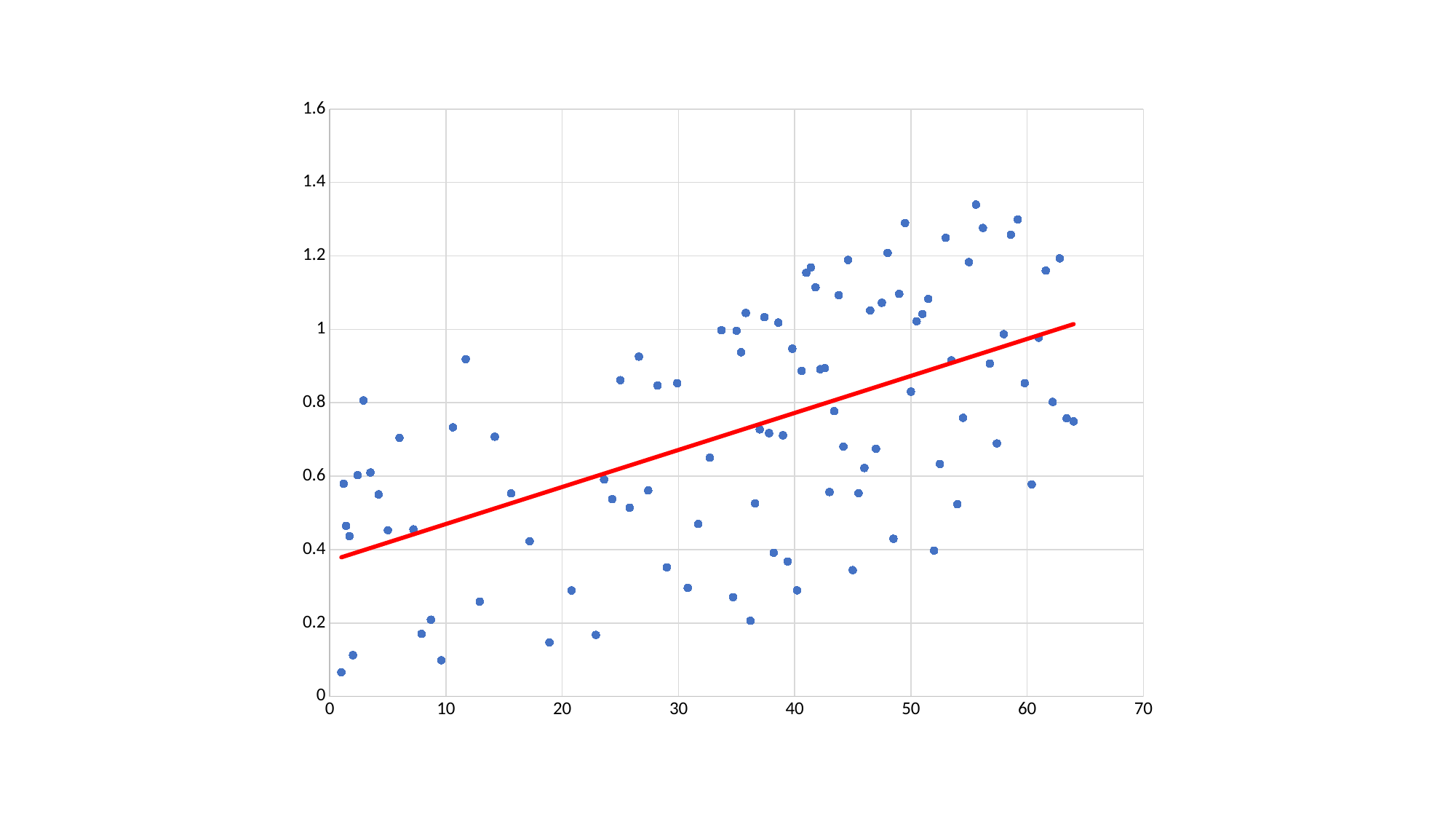
Are any plotted points above 1.4 on the y axis? no What kind of chart is shown on the slide? scatter chart Is the value of the red trend line at x = 50 greater or less than 0.8? greater Is the value of the red trend line at x = 30 greater or less than 0.8? less Does the red trend line slope upward or downward from left to right? upward What colour is the trend line on the chart? red What is the highest tick value shown on the x axis? 70 Do the plotted values generally rise or fall as the x-axis value increases? rise